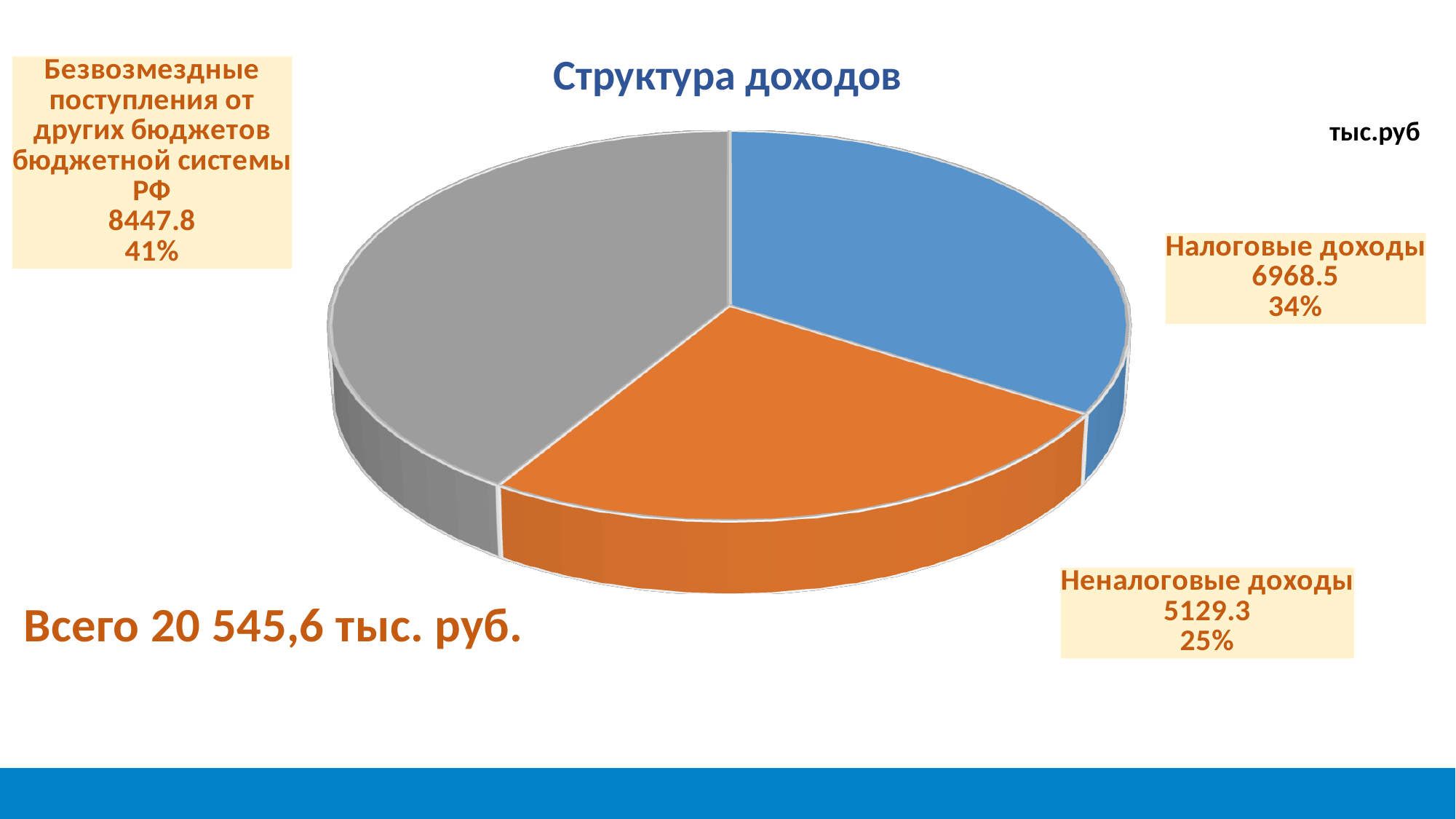
Which category has the largest value? Безвозмездные поступления от других бюджетов бюджетной системы РФ What share of the pie does Налоговые доходы represent? 34% What share of the pie does Безвозмездные поступления от других бюджетов бюджетной системы РФ represent? 41% Which category has the smallest value? Неналоговые доходы What is the difference between Налоговые доходы and Неналоговые доходы? 1839.2 Which is larger, Налоговые доходы or Неналоговые доходы? Налоговые доходы What is the difference between Безвозмездные поступления от других бюджетов бюджетной системы РФ and Налоговые доходы? 1479.3 What type of chart is shown on the slide? Pie chart How many slices does the pie chart have? 3 What is the value for Неналоговые доходы? 5129.3 What is the value for Безвозмездные поступления от других бюджетов бюджетной системы РФ? 8447.8 What is the value for Налоговые доходы? 6968.5